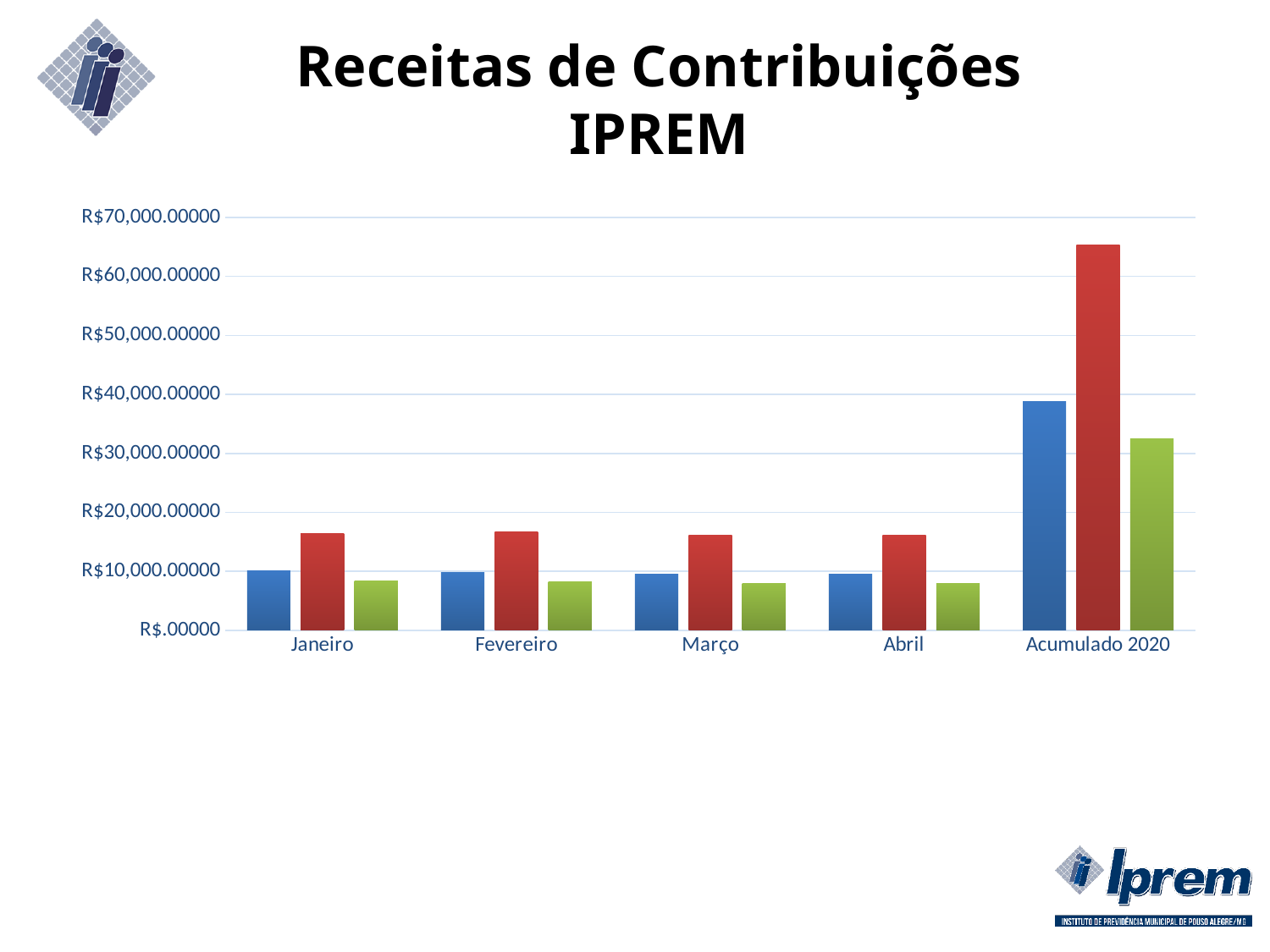
Is the green bar for Abril greater or less than R$10,000.00000? less What is the title of the chart on the slide? Receitas de Contribuições IPREM Is the red bar for Acumulado 2020 greater or less than R$60,000.00000? greater Which category has the tallest bar on the chart? Acumulado 2020 What kind of chart is shown on the slide? bar chart Is the red bar for Janeiro greater or less than R$10,000.00000? greater How many bars are plotted for each category on the chart? 3 In the Janeiro category, which coloured bar is the shortest? green How many categories are shown on the x axis of the chart? 5 In the Acumulado 2020 category, which is larger, the blue bar or the red bar? red bar In the Acumulado 2020 category, which coloured bar is the tallest? red